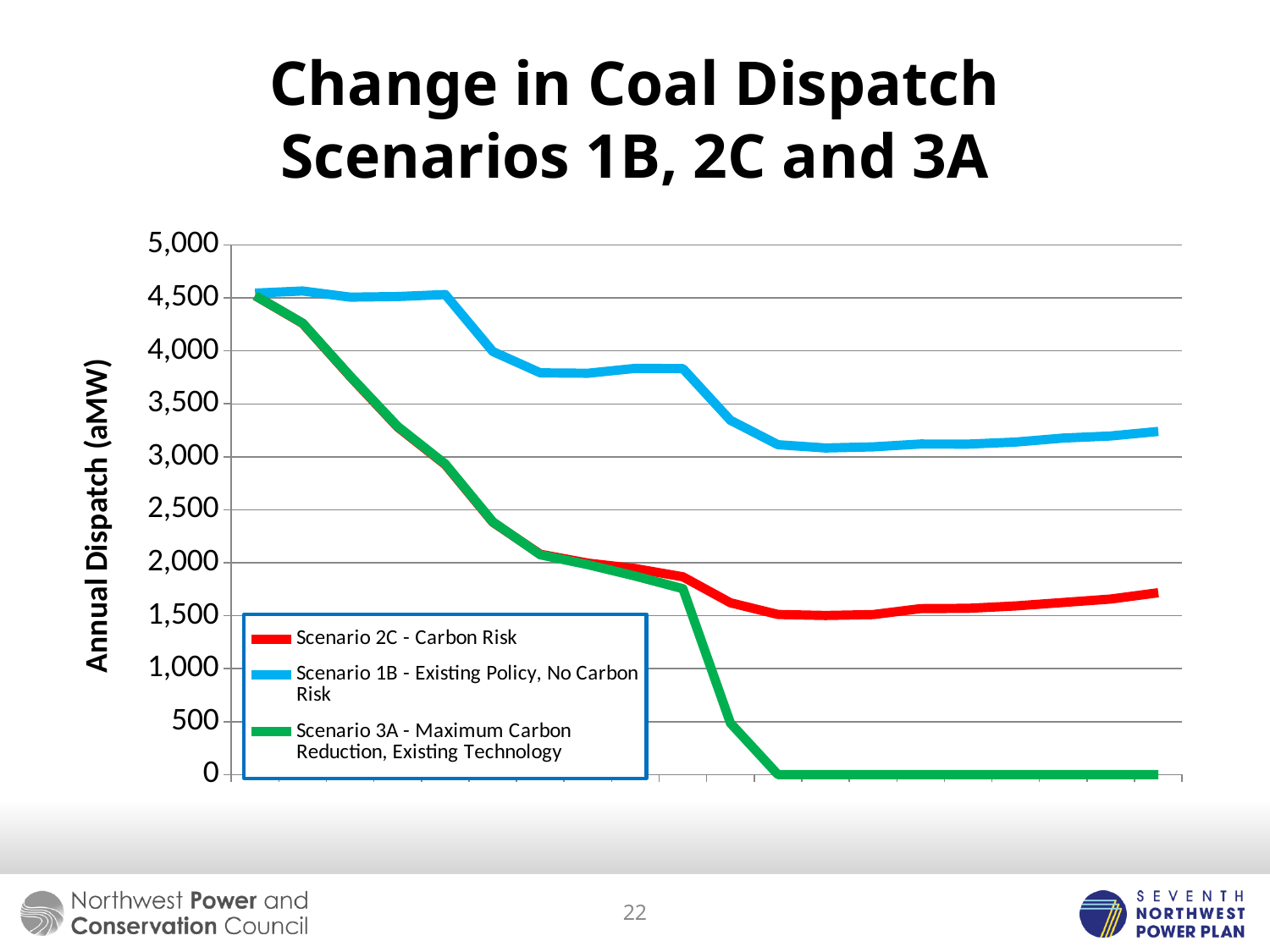
At the right end of the chart, which is larger: Scenario 2C - Carbon Risk or Scenario 1B - Existing Policy, No Carbon Risk? Scenario 1B - Existing Policy, No Carbon Risk Which colour is used for the Scenario 3A - Maximum Carbon Reduction, Existing Technology line? green Which series has the lowest values at the right end of the chart? Scenario 3A - Maximum Carbon Reduction, Existing Technology At the right end of the chart, is the value for Scenario 1B - Existing Policy, No Carbon Risk greater or less than 3,000? greater Which series has the highest values at the right end of the chart? Scenario 1B - Existing Policy, No Carbon Risk What kind of chart is shown on the slide? line chart At the right end of the chart, is the value for Scenario 2C - Carbon Risk greater or less than 2,000? less Does the Scenario 3A - Maximum Carbon Reduction, Existing Technology line rise or fall along the x axis? fall At the left end of the chart, is the value for Scenario 1B - Existing Policy, No Carbon Risk greater or less than 4,000? greater What value does the Scenario 3A - Maximum Carbon Reduction, Existing Technology line reach at the right end of the chart? 0 What is the title of the vertical axis? Annual Dispatch (aMW) How many series does the legend list? 3